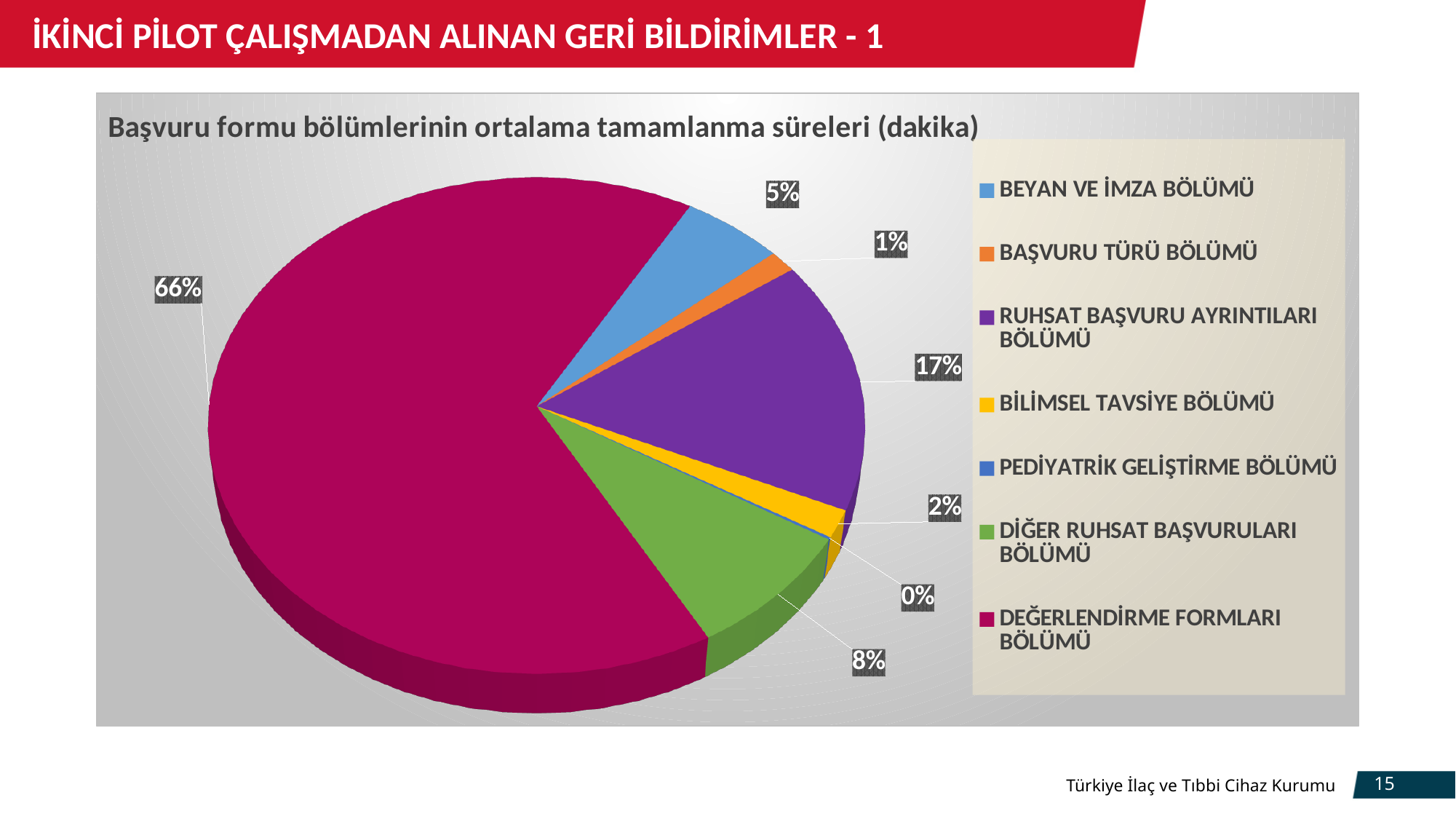
Which category has the largest share of the pie? DEĞERLENDİRME FORMLARI BÖLÜMÜ What is the title of the chart? Başvuru formu bölümlerinin ortalama tamamlanma süreleri (dakika) What kind of chart is shown on the slide? pie chart What share of the pie does BİLİMSEL TAVSİYE BÖLÜMÜ have? 2% What share of the pie does BEYAN VE İMZA BÖLÜMÜ have? 5% How many categories does the legend list? 7 What share of the pie does DEĞERLENDİRME FORMLARI BÖLÜMÜ have? 66% Which category has the smallest share of the pie? PEDİYATRİK GELİŞTİRME BÖLÜMÜ Which has a larger share, BEYAN VE İMZA BÖLÜMÜ or BAŞVURU TÜRÜ BÖLÜMÜ? BEYAN VE İMZA BÖLÜMÜ What is the difference in percentage points between the shares of RUHSAT BAŞVURU AYRINTILARI BÖLÜMÜ and DİĞER RUHSAT BAŞVURULARI BÖLÜMÜ? 9%